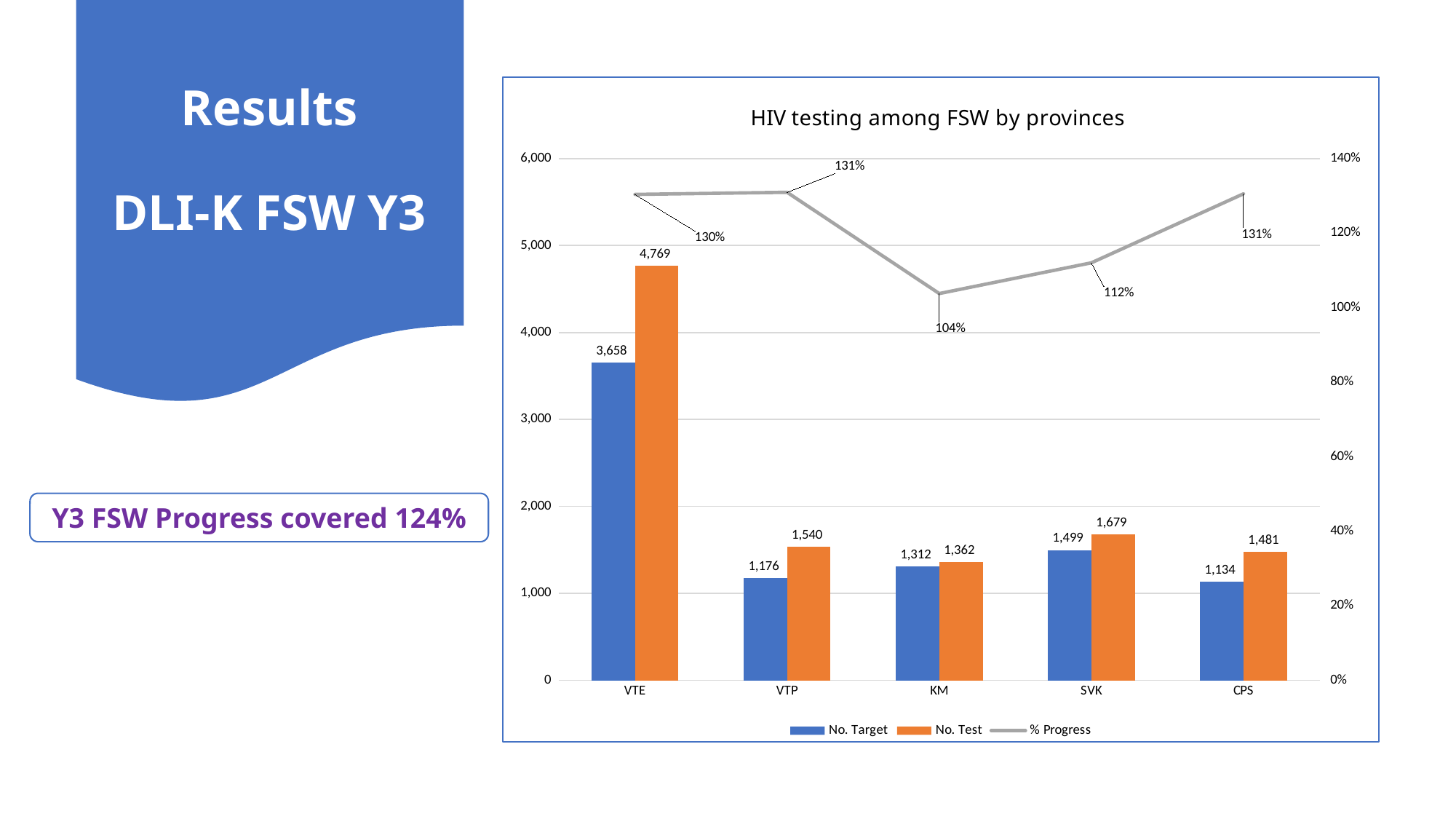
What kind of chart is used for the No. Target and No. Test series? Bar chart What is the No. Target value for SVK? 1,499 Which province has the highest No. Test value? VTE Which province has the lowest No. Target value? CPS Which is larger for KM: No. Target or No. Test? No. Test What is the % Progress value for KM? 104% How many provinces are shown on the x axis? 5 Which province has the lowest % Progress? KM How many series does the legend list? 3 What is the title of the chart? HIV testing among FSW by provinces What is the difference between No. Test and No. Target for VTE? 1,111 What is the No. Test value for VTE? 4,769